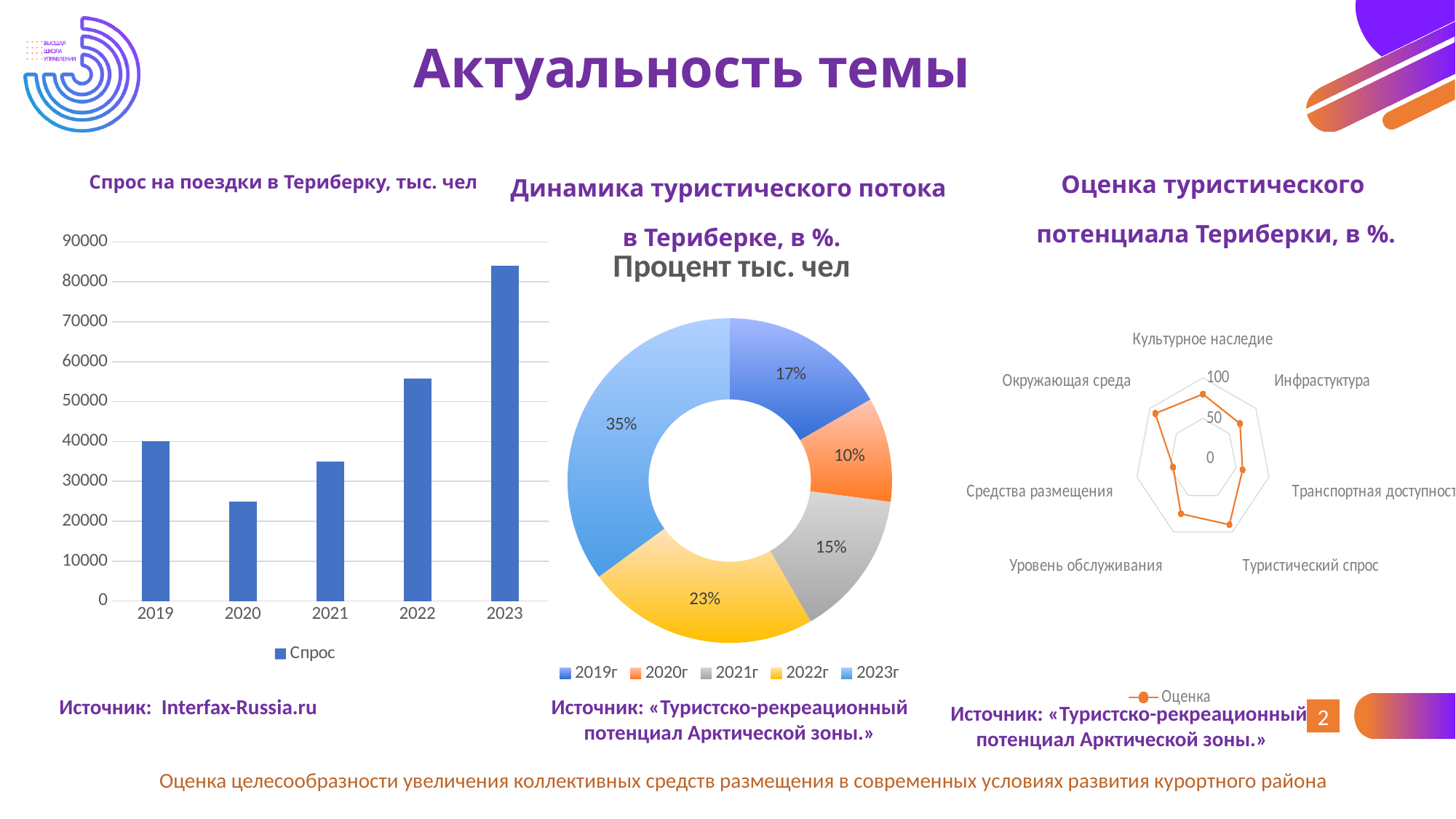
In the left bar chart 'Спрос на поездки в Териберку', which is larger, the value for 2021 or the value for 2022? 2022 What kind of chart is the left chart titled 'Спрос на поездки в Териберку, тыс. чел'? Bar chart In the middle donut chart 'Динамика туристического потока в Териберке', what is the difference between the shares for 2023г and 2019г? 18% In the right radar chart 'Оценка туристического потенциала Териберки', how many categories are shown around the chart? 7 In the left bar chart 'Спрос на поездки в Териберку', how many years are shown on the x axis? 5 In the middle donut chart 'Динамика туристического потока в Териберке', what is the share for 2023г? 35% In the left bar chart 'Спрос на поездки в Териберку', which year has the lowest value? 2020 In the left bar chart 'Спрос на поездки в Териберку', which year has the highest value? 2023 In the left bar chart 'Спрос на поездки в Териберку', is the value for 2020 greater or less than 30000? less How many entries does the legend of the middle donut chart 'Динамика туристического потока в Териберке' list? 5 In the left bar chart 'Спрос на поездки в Териберку', is the value for 2023 greater or less than 80000? greater In the middle donut chart 'Динамика туристического потока в Териберке', which year has the smallest share? 2020г